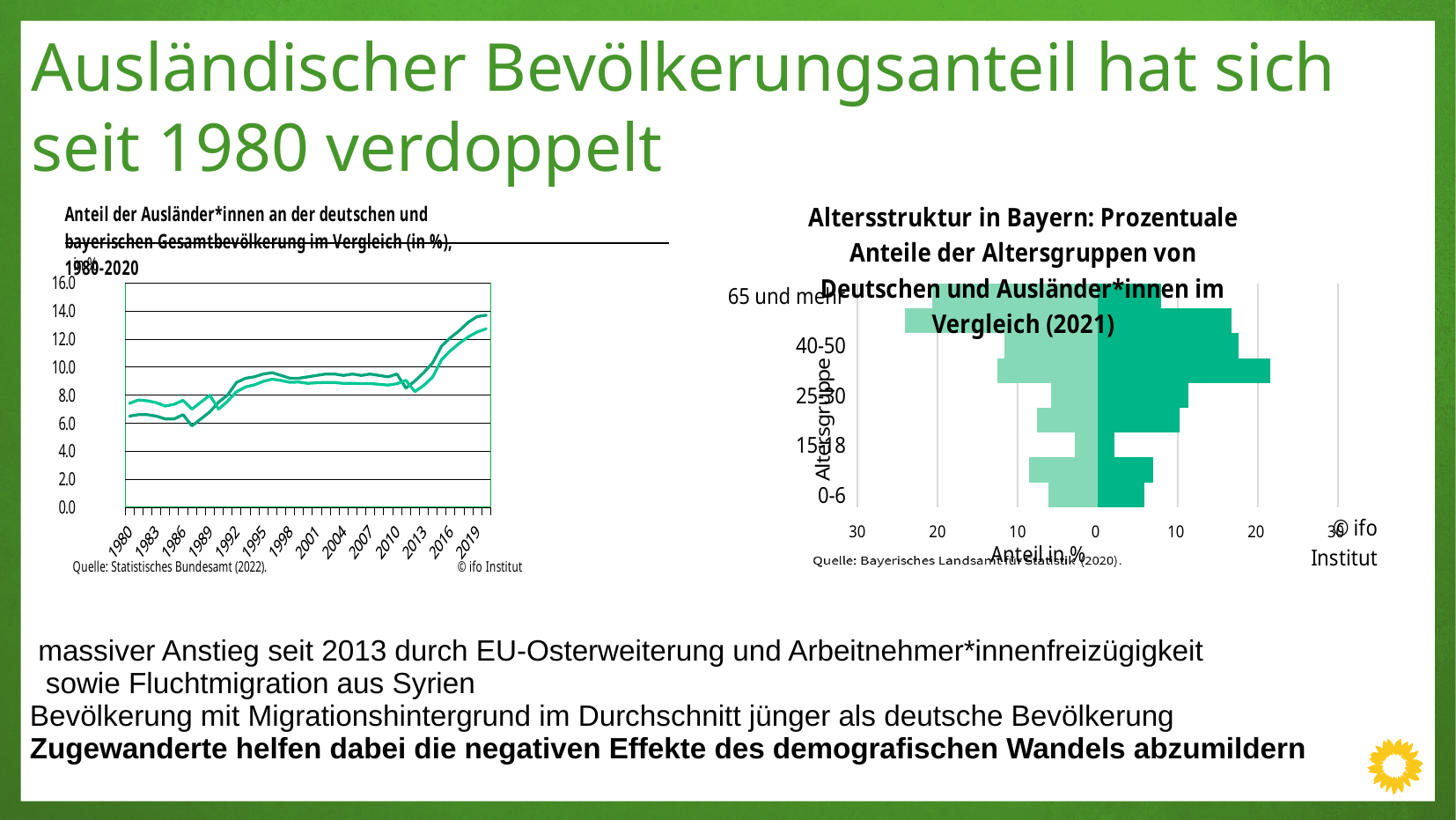
In the left chart, do the plotted values generally rise or fall from 1980 to 2019? rise What is the x-axis label of the right chart? Anteil in % In the left chart, is the value of the upper line in 2019 greater or less than 12.0? greater What is the highest tick value shown on the y axis of the left chart? 16.0 How many lines are plotted in the left chart? 2 In the left chart, is the value of the lower line in 1980 greater or less than 8.0? less What is the y-axis label of the right chart? Altersgruppe In the left chart, is the value of the upper line in 2001 greater or less than 6.0? greater What kind of chart is the left chart, 'Anteil der Ausländer*innen an der deutschen und bayerischen Gesamtbevölkerung im Vergleich'? line chart What kind of chart is the right chart, 'Altersstruktur in Bayern'? bar chart